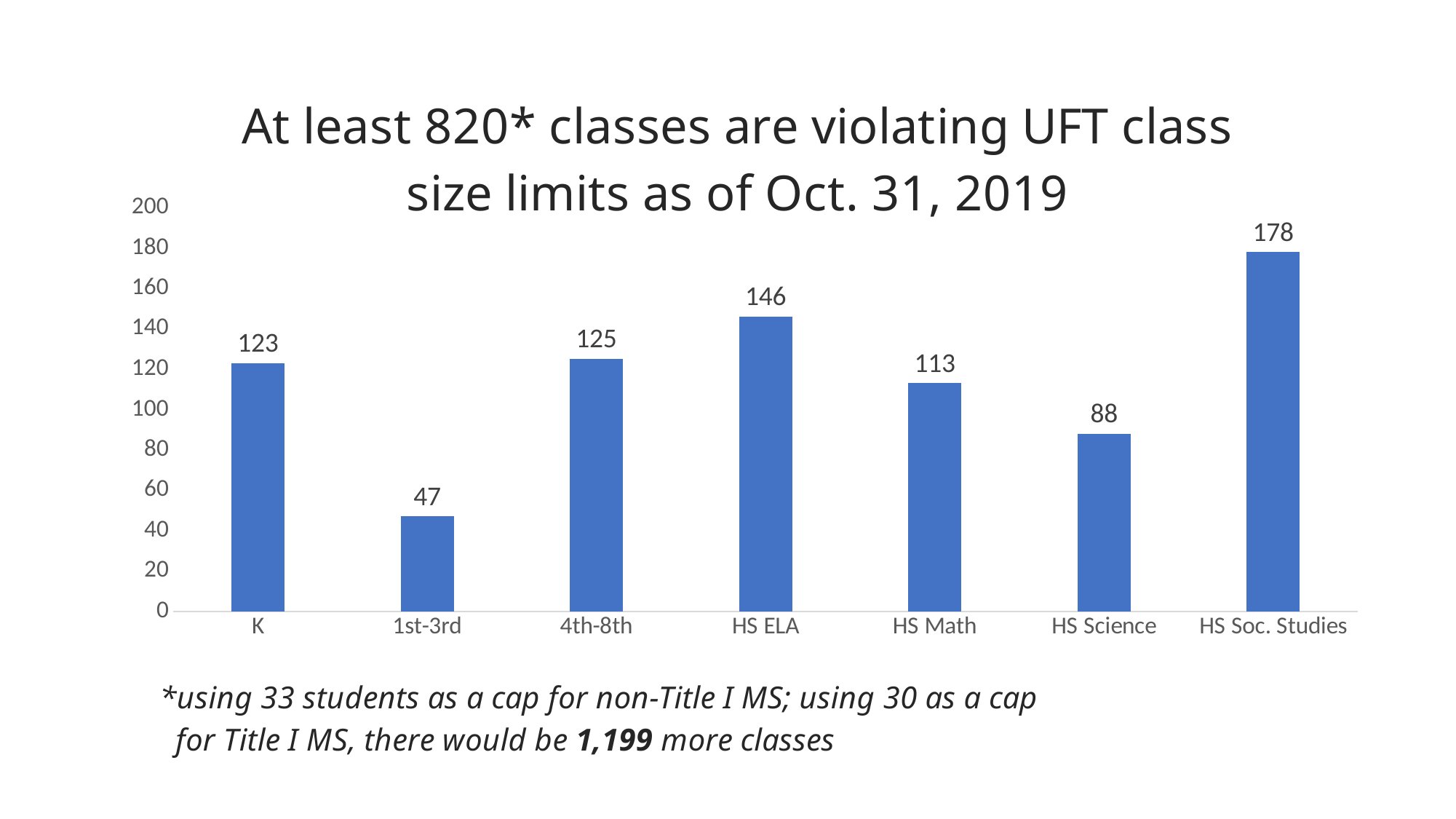
How many categories are shown on the x axis? 7 Is the value for HS Math greater or less than 100? greater Which is larger, the value for 4th-8th or the value for K? 4th-8th What is the difference between the values for K and 1st-3rd? 76 Which category has the lowest value? 1st-3rd What is the difference between the values for HS Soc. Studies and HS Math? 65 What kind of chart is shown on the slide? bar chart What is the value for HS Science? 88 Which category has the highest value? HS Soc. Studies What is the value for HS ELA? 146 What is the value for 1st-3rd? 47 What is the title of the chart? At least 820* classes are violating UFT class size limits as of Oct. 31, 2019